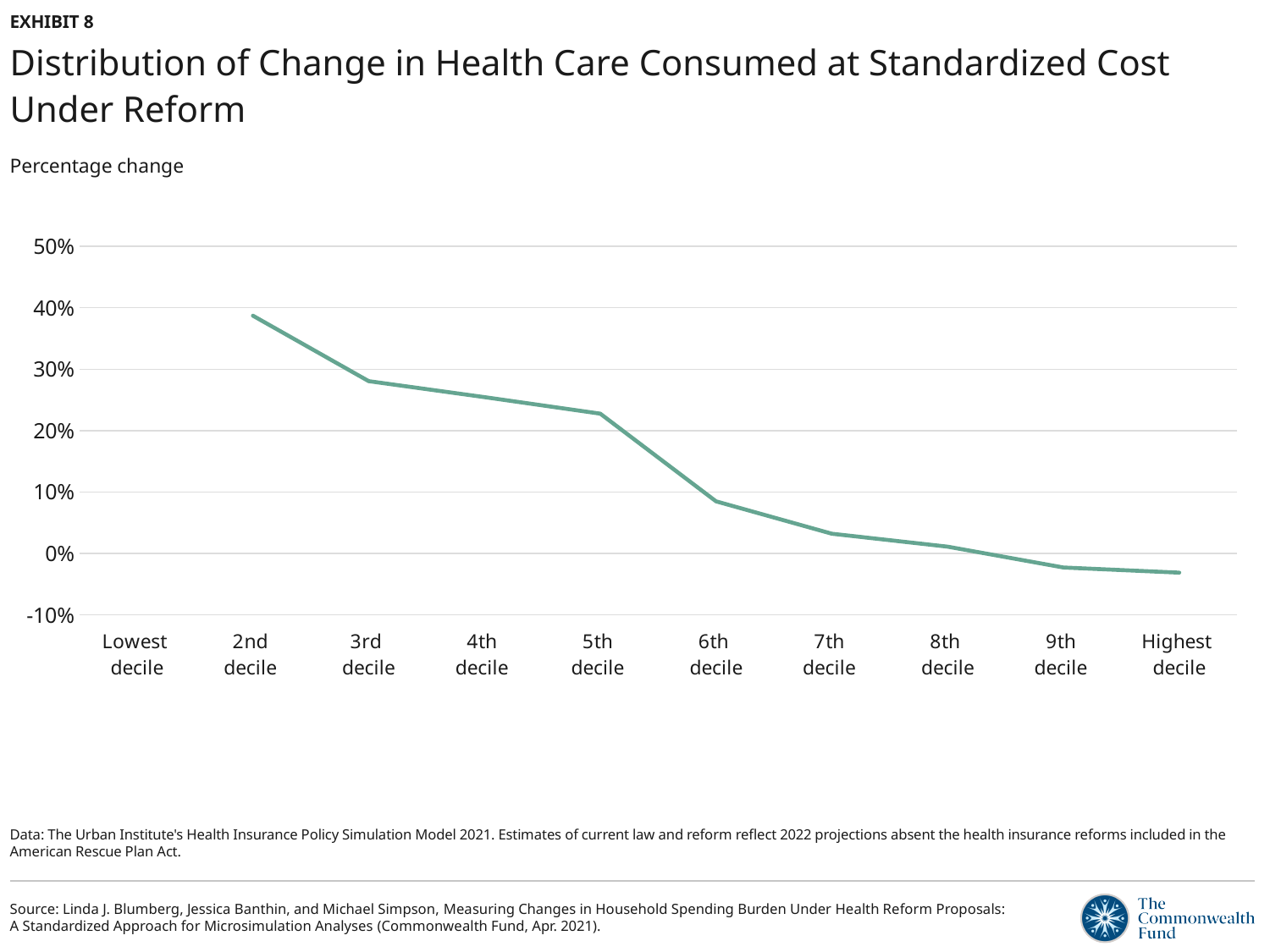
Do the values rise or fall moving from the 2nd decile to the Highest decile? fall Which has a larger percentage change, the 4th decile or the 7th decile? 4th decile Is the value for the 2nd decile greater or less than 30%? greater What is the label shown above the chart describing the y-axis measure? Percentage change Is the value for the 3rd decile greater or less than 30%? less Is the value for the Highest decile greater or less than 0%? less Which has a larger percentage change, the 5th decile or the 6th decile? 5th decile How many decile categories are labeled on the x axis? 10 What kind of chart is shown on the slide? line chart Which decile has the highest percentage change? 2nd decile